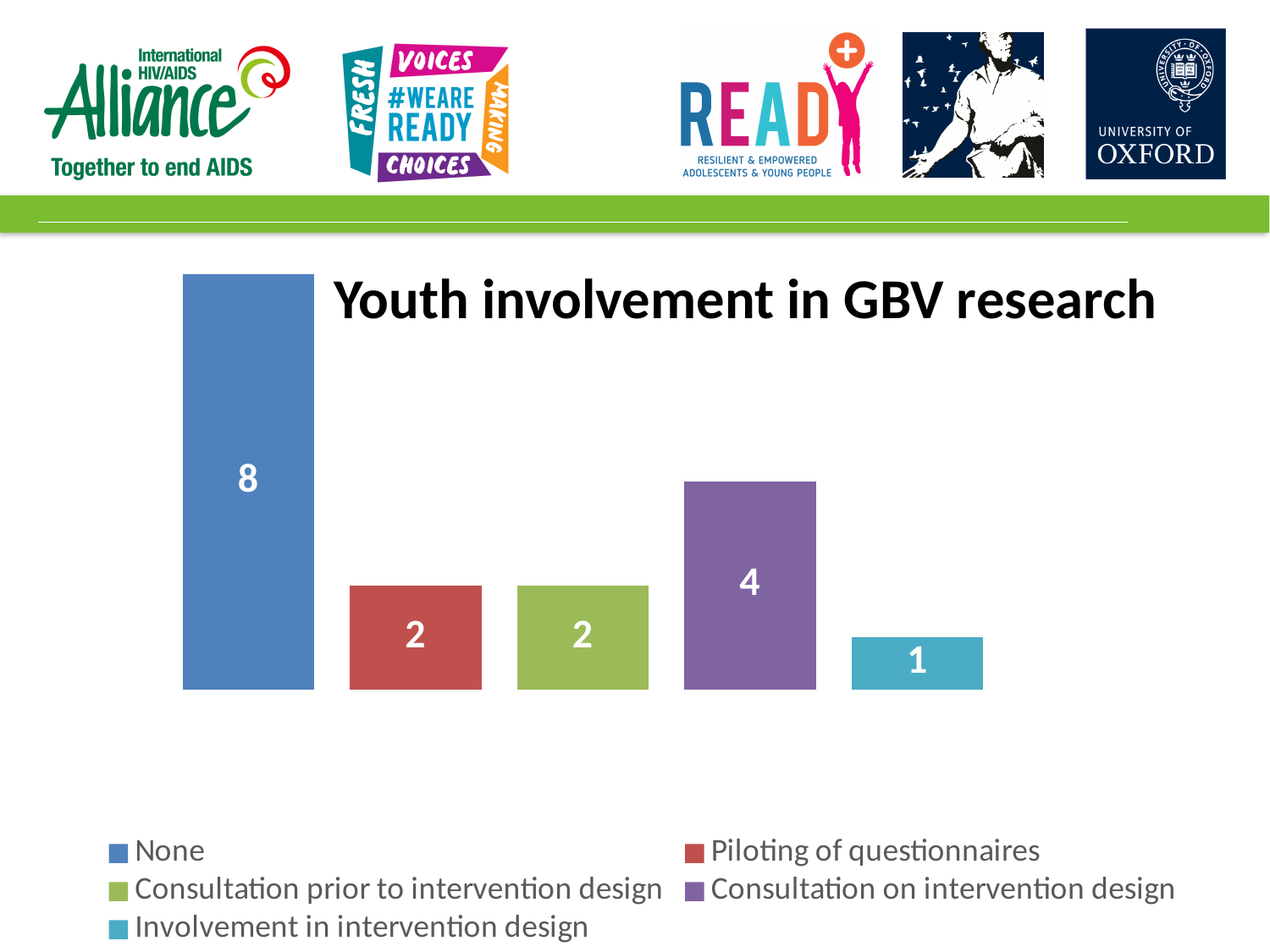
What is the difference between the values for None and Consultation on intervention design? 4 How many entries does the legend list? 5 What is the title of the chart? Youth involvement in GBV research What is the value for Consultation on intervention design? 4 What is the value for Piloting of questionnaires? 2 Which category has the lowest value in the chart? Involvement in intervention design Which is larger: the value for Consultation on intervention design or the value for Consultation prior to intervention design? Consultation on intervention design What is the value for Involvement in intervention design? 1 Which category has the highest value in the chart? None What kind of chart is shown on the slide? Bar chart What is the value for None in the Youth involvement in GBV research chart? 8 How many bars are plotted in the chart? 5